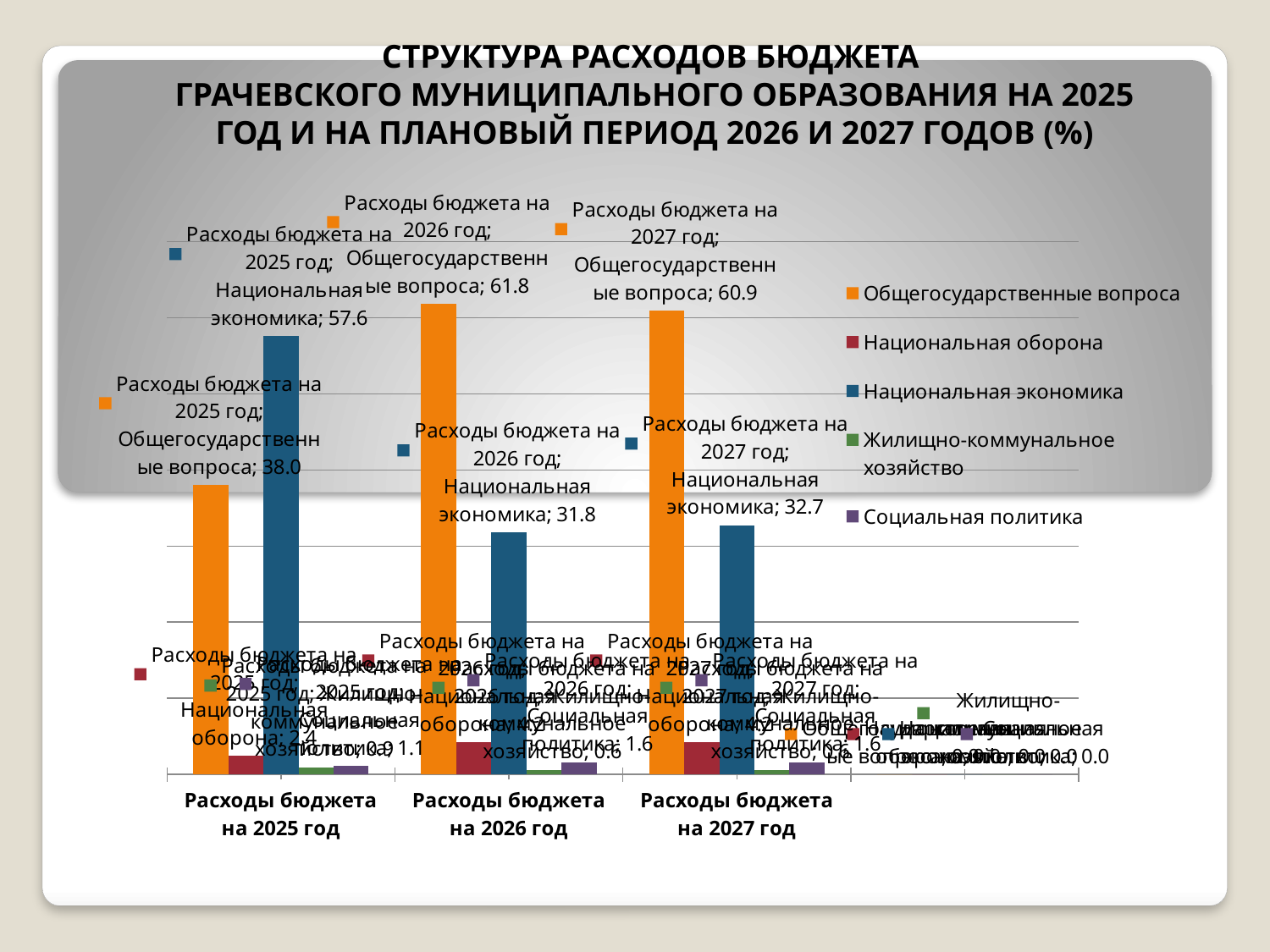
What is the difference between Национальная экономика in 2025 and Национальная экономика in 2026? 25.8 What is the value for Общегосударственные вопросы in Расходы бюджета на 2026 год? 61.8 How many budget years (category groups) are shown on the x axis? 3 What is the value for Национальная экономика in Расходы бюджета на 2026 год? 31.8 What is the value for Общегосударственные вопросы in Расходы бюджета на 2027 год? 60.9 What kind of chart is shown on the slide? Bar chart How many series does the legend list? 5 What is the value for Национальная экономика in Расходы бюджета на 2027 год? 32.7 In Расходы бюджета на 2025 год, which is larger: Общегосударственные вопросы or Национальная экономика? Национальная экономика What is the value for Общегосударственные вопросы in Расходы бюджета на 2025 год? 38.0 What is the value for Национальная экономика in Расходы бюджета на 2025 год? 57.6 In Расходы бюджета на 2026 год, what is the difference between Общегосударственные вопросы and Национальная экономика? 30.0